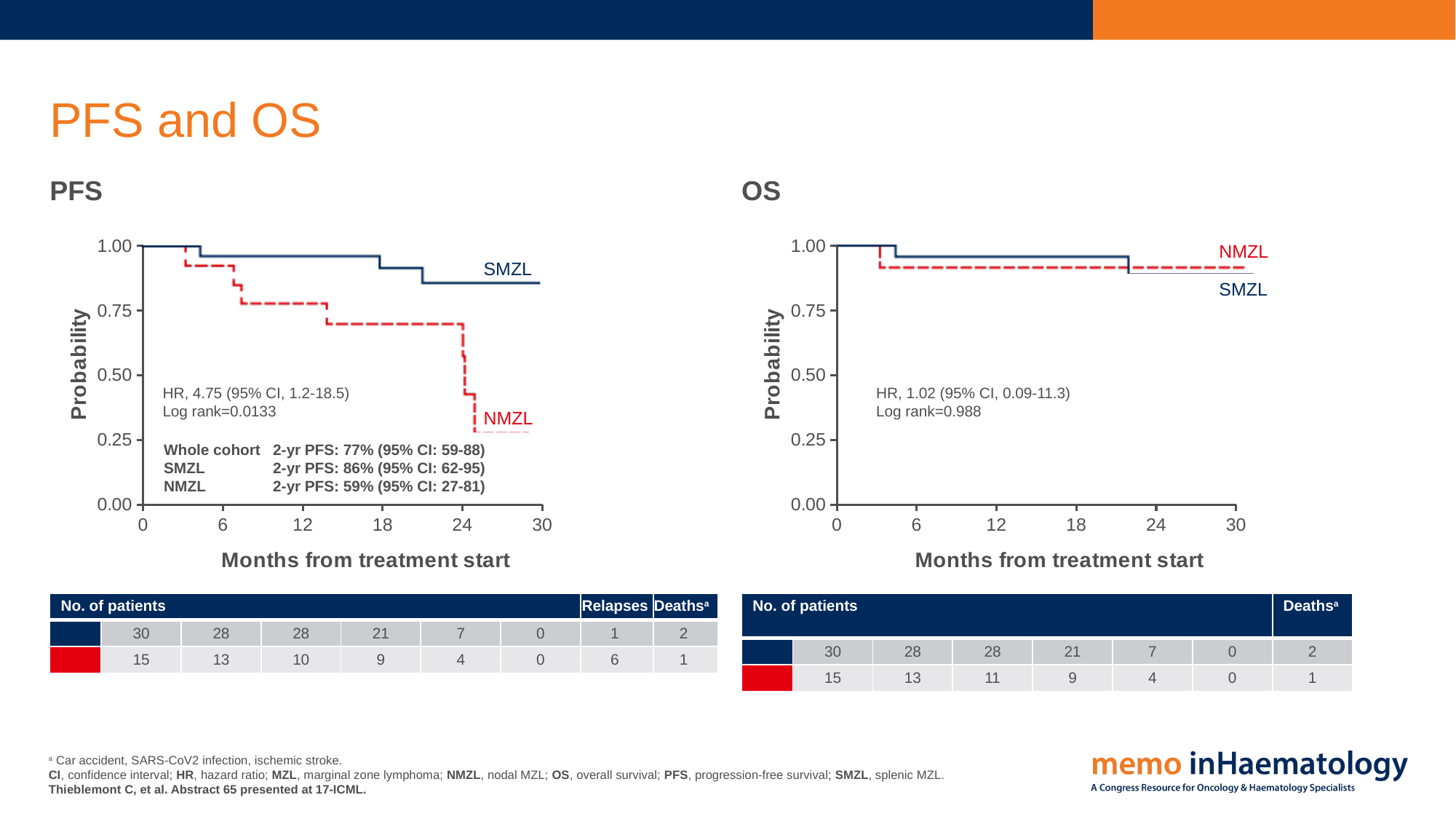
How many groups (curves) are plotted on the OS chart? 2 On the PFS chart, what is the 2-yr PFS for SMZL? 86% (95% CI: 62-95) On the PFS chart, what is the difference between the 2-yr PFS of SMZL and NMZL? 27% On the PFS chart, what hazard ratio is shown? 4.75 (95% CI, 1.2-18.5) On the PFS chart, is the NMZL probability at 18 months greater or less than 0.75? less On the PFS chart, which group has the higher 2-yr PFS, SMZL or NMZL? SMZL What kind of chart is the PFS chart? Line chart (Kaplan-Meier survival curve) On the PFS chart, does the NMZL curve rise or fall as months from treatment start increase? Fall On the PFS chart, what is the 2-yr PFS for the whole cohort? 77% (95% CI: 59-88) On the PFS chart, is the SMZL probability at 24 months greater or less than 0.75? greater On the PFS chart, what is the 2-yr PFS for NMZL? 59% (95% CI: 27-81) On the OS chart, what is the log rank p-value? 0.988